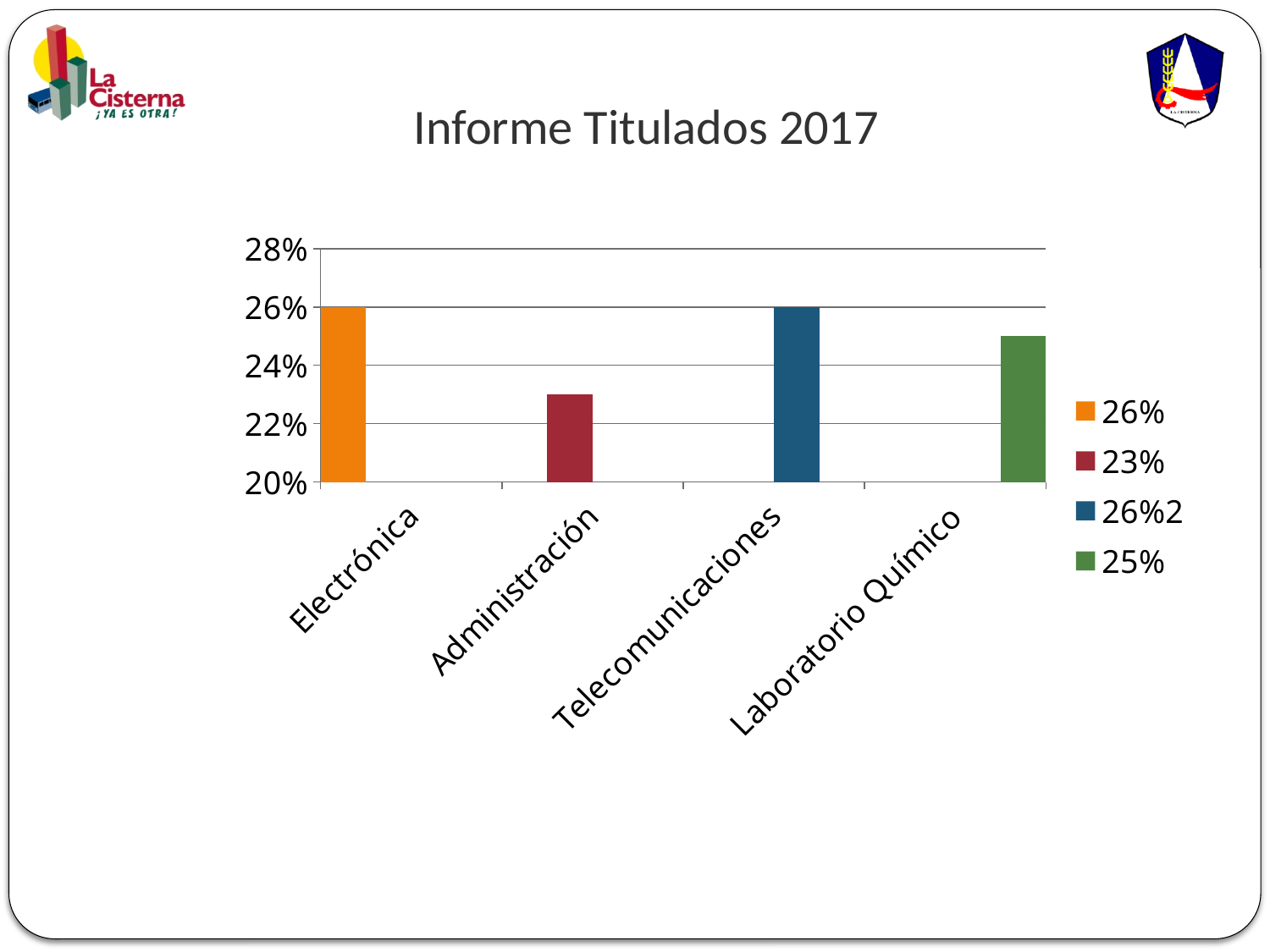
What colour is the bar for Electrónica? orange What type of chart is shown on the slide? bar chart How many entries does the chart's legend list? 4 What is the value for Electrónica? 26% Which category has the lowest value? Administración How many categories are shown on the x axis of the chart? 4 Which is larger, the value for Electrónica or the value for Administración? Electrónica Is the value for Administración greater or less than 24%? less Which is larger, the value for Laboratorio Químico or the value for Administración? Laboratorio Químico Is the value for Laboratorio Químico greater or less than 24%? greater What is the title of the slide? Informe Titulados 2017 What is the value for Telecomunicaciones? 26%